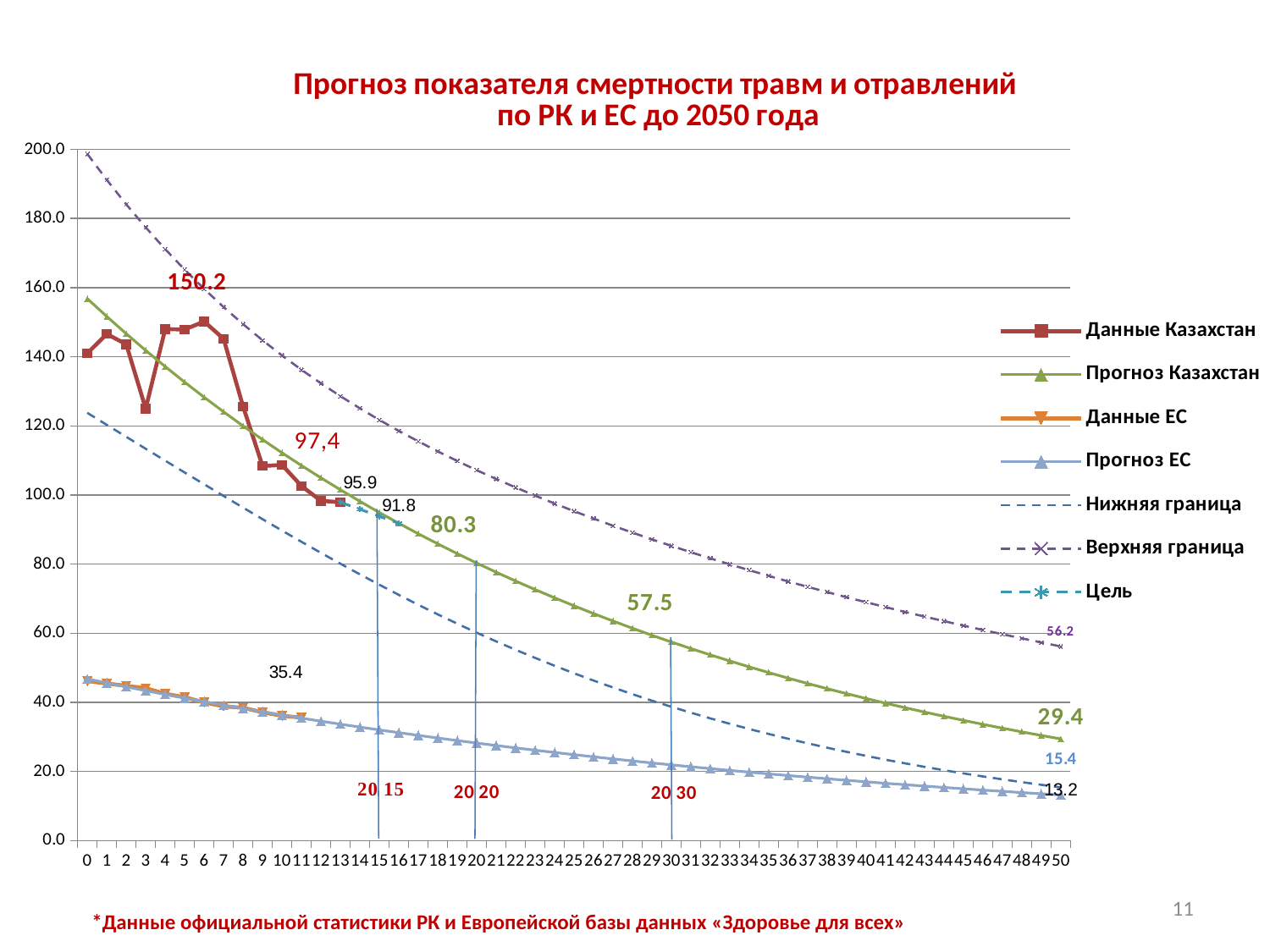
Is the value of Данные ЕС at x = 0 greater or less than 40? greater What is the value labeled at the end of the Прогноз Казахстан series (x = 50)? 29.4 How many series does the legend list? 7 What kind of chart is shown on the slide? line chart What is the value labeled at the end of the Нижняя граница series? 15.4 Does the Прогноз Казахстан series rise or fall along the x axis? fall What is the value labeled on the Прогноз Казахстан series at the 2020 line? 80.3 What is the title of the chart? Прогноз показателя смертности травм и отравлений по РК и ЕС до 2050 года What is the value labeled on the Прогноз Казахстан series at the 2030 line? 57.5 What is the value labeled at the end of the Прогноз ЕС series (x = 50)? 13.2 What is the value labeled at the end of the Верхняя граница series? 56.2